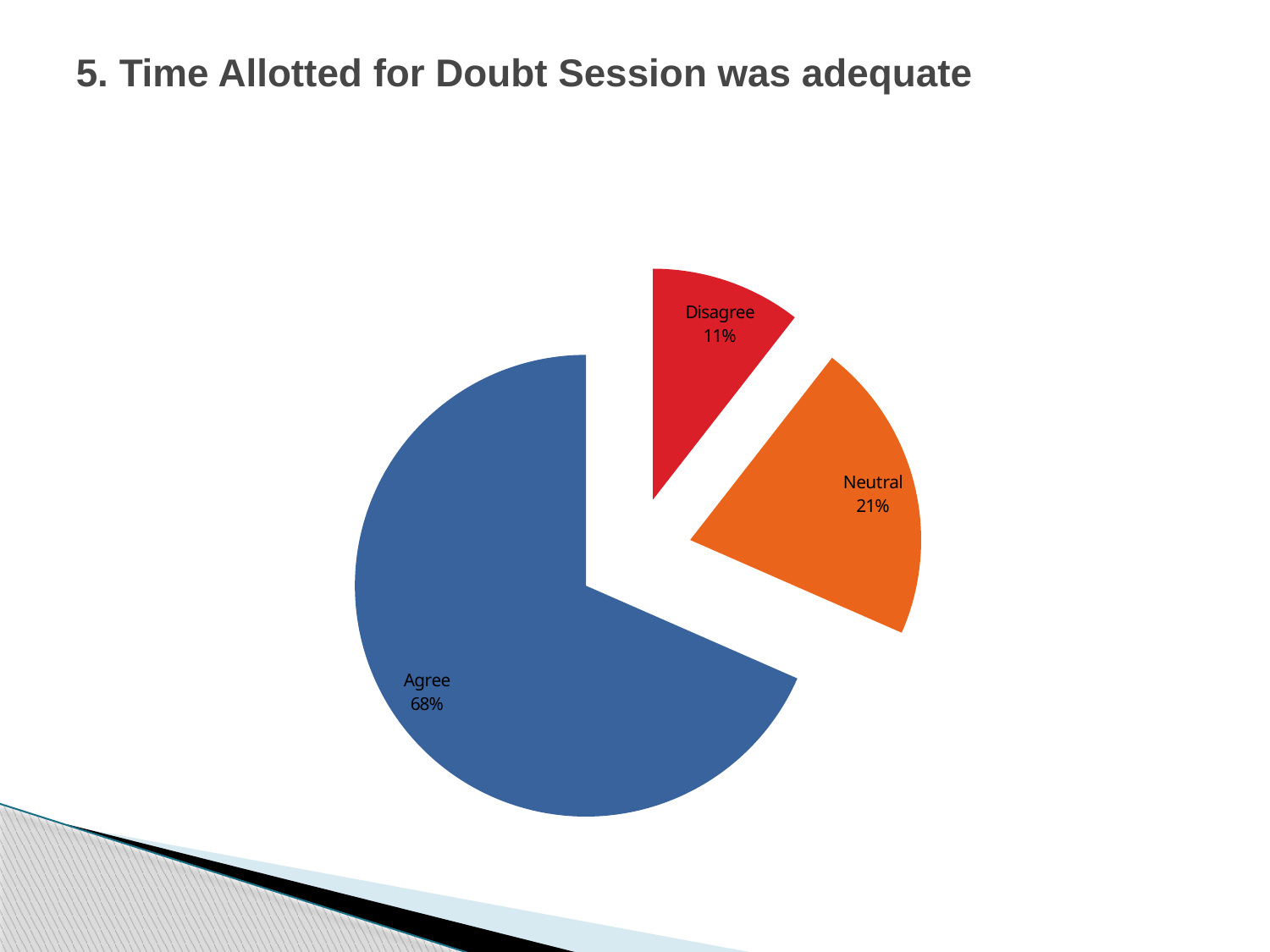
What is the difference in percentage points between Agree and Neutral? 47 Which response has the largest share of the pie? Agree What is the title of the slide containing the pie chart? 5. Time Allotted for Doubt Session was adequate Which is larger, the share for Neutral or the share for Disagree? Neutral How many slices does the pie chart have? 3 What percentage of respondents chose Neutral? 21% Which response has the smallest share of the pie? Disagree What is the difference in percentage points between Neutral and Disagree? 10 What colour is the Agree slice? blue What percentage of respondents chose Disagree? 11% What percentage of respondents chose Agree? 68% What kind of chart is shown on the slide? pie chart